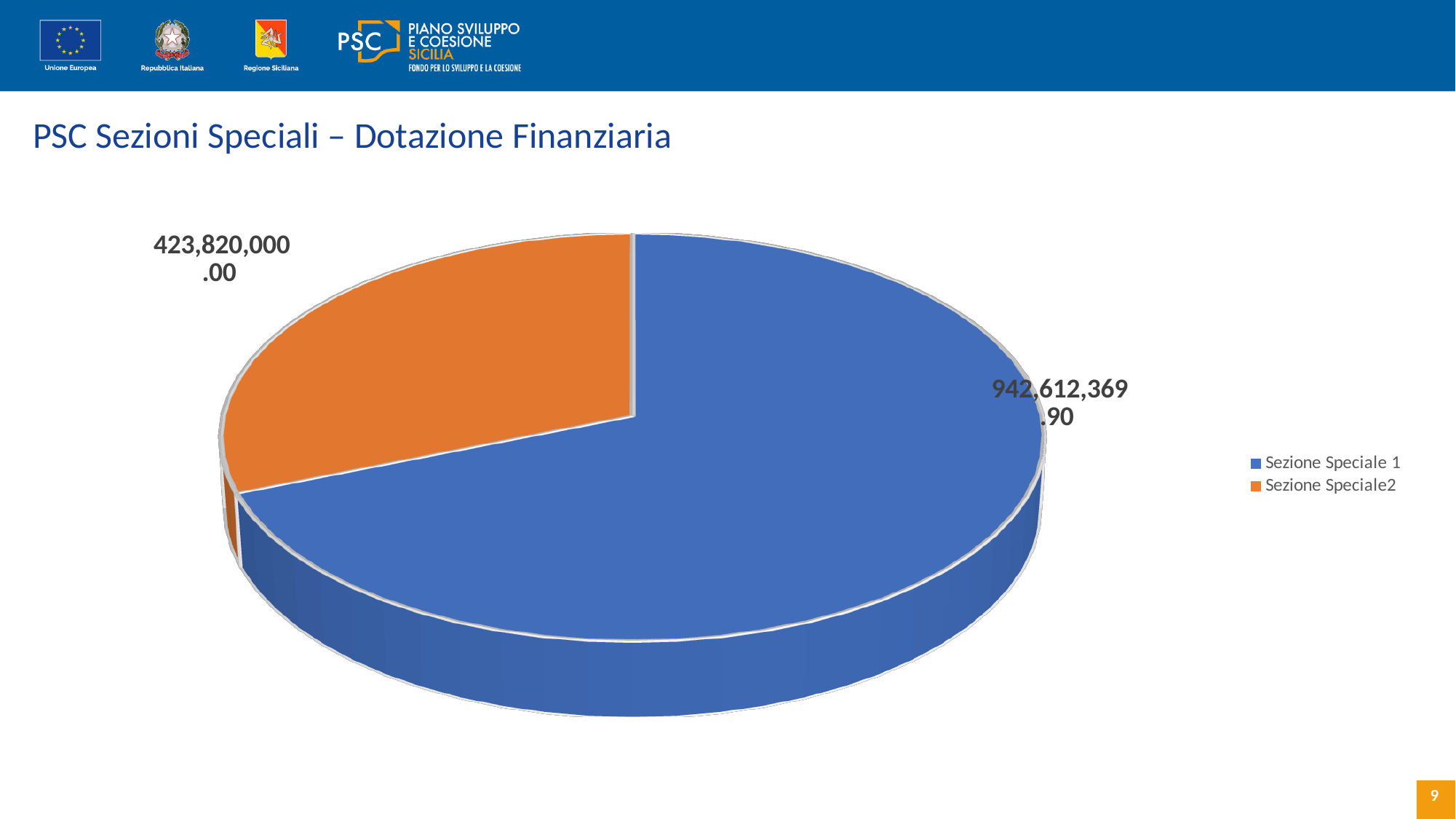
What colour is the slice for Sezione Speciale2? Orange What is the title of the slide containing the chart? PSC Sezioni Speciali – Dotazione Finanziaria What is the total of the two slices in the pie chart? 1,366,432,369.90 Which section has the smallest slice of the pie? Sezione Speciale2 What is the difference between the values for Sezione Speciale 1 and Sezione Speciale2? 518,792,369.90 Which section has the largest slice of the pie? Sezione Speciale 1 What is the value for Sezione Speciale2? 423,820,000.00 What is the value for Sezione Speciale 1? 942,612,369.90 How many slices does the pie chart have? 2 What type of chart is shown on the slide? Pie chart How many entries does the legend list? 2 Which is larger, the value for Sezione Speciale 1 or Sezione Speciale2? Sezione Speciale 1